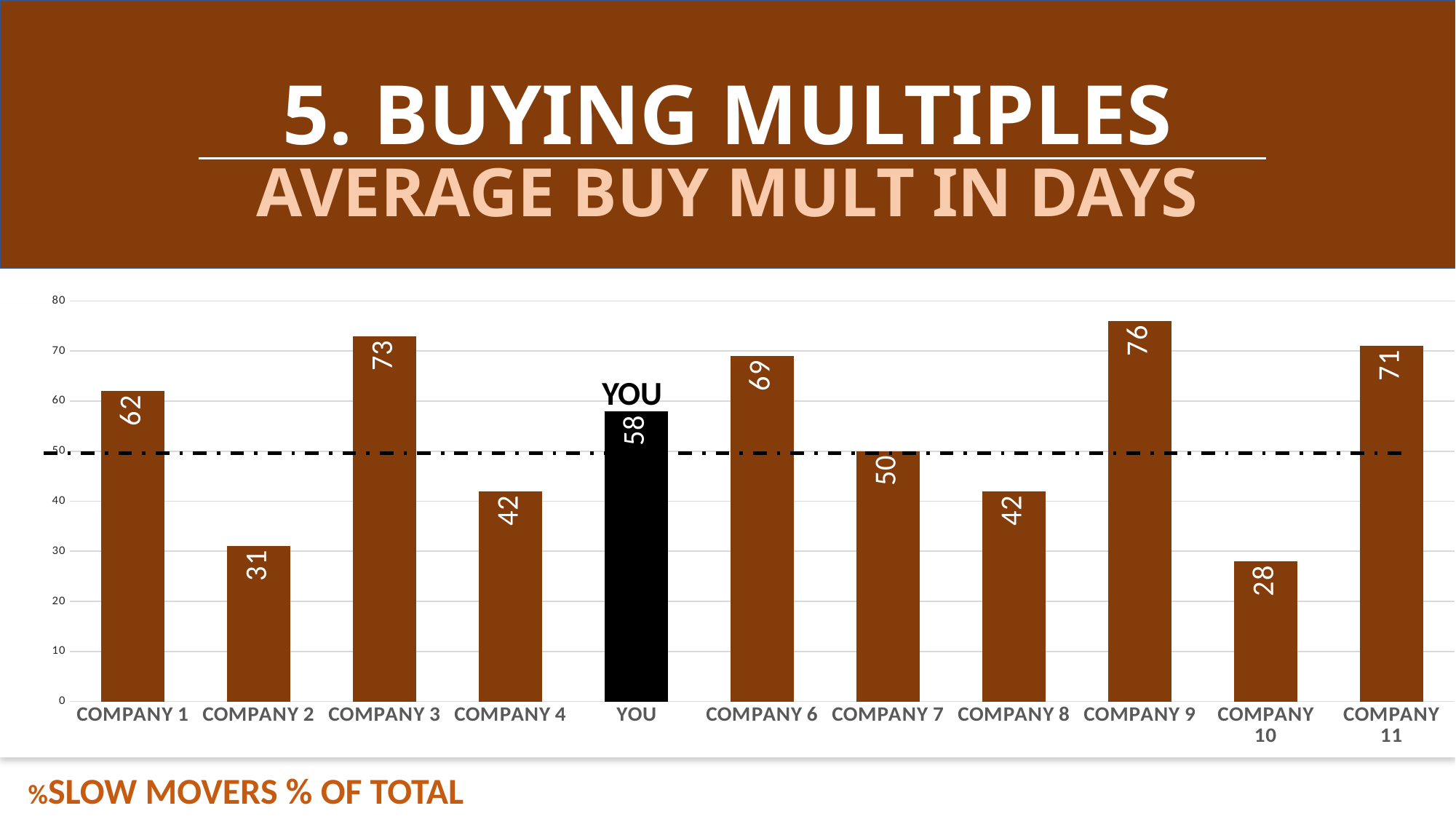
What is the value for the YOU bar? 58 What is the difference between COMPANY 1 and COMPANY 2? 31 Which category has the lowest value? COMPANY 10 Which is larger, COMPANY 6 or COMPANY 11? COMPANY 11 How many bars are shown in the chart? 11 Which bar is coloured black instead of brown? YOU Is the value for COMPANY 7 greater or less than 40? greater What is the difference between COMPANY 9 and YOU? 18 What is the value for COMPANY 3? 73 What kind of chart is shown on the slide? bar chart Which category has the highest value? COMPANY 9 What is the value for COMPANY 10? 28